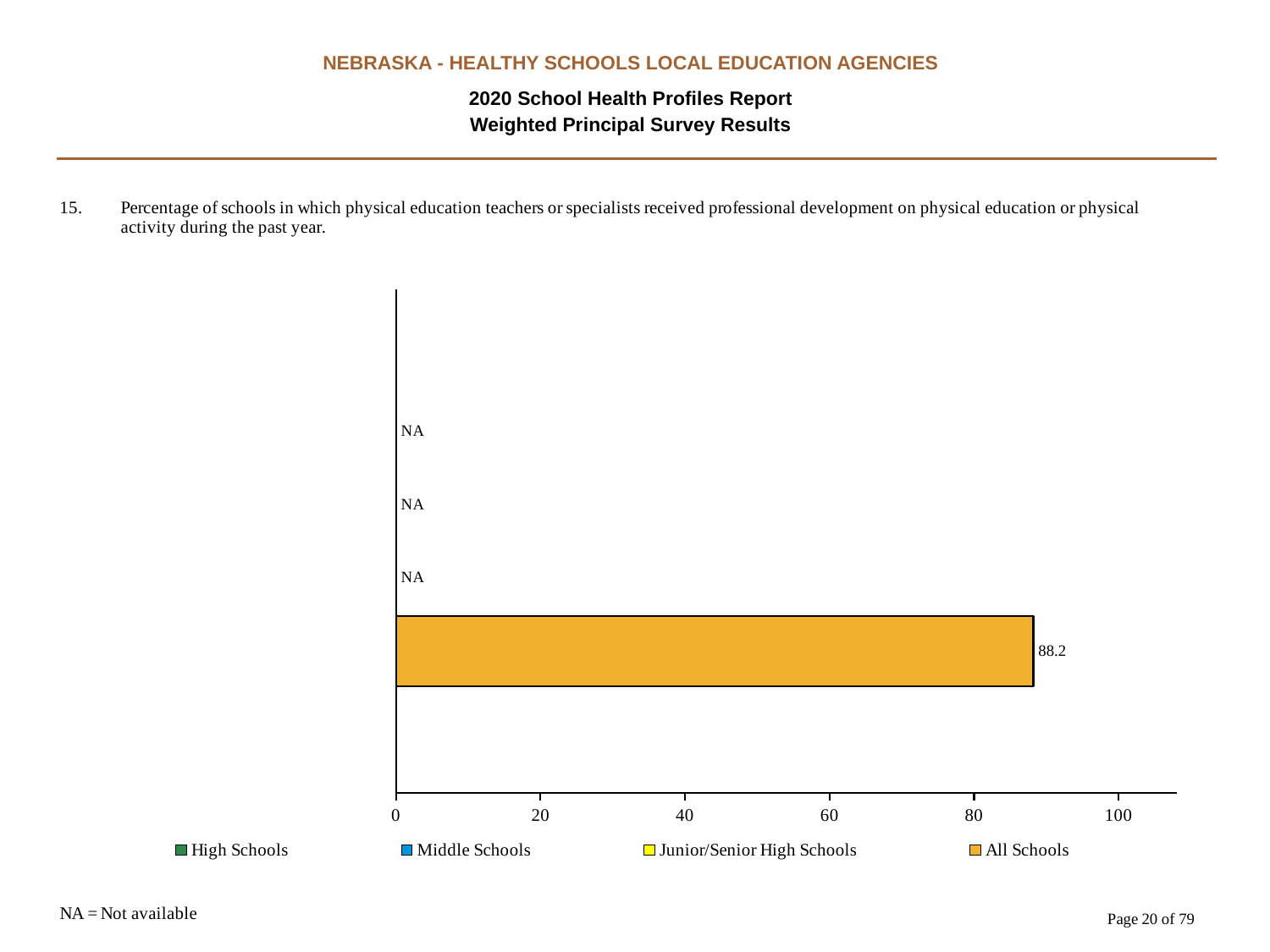
What is the highest value shown on the x axis? 100 Which series is shown in orange in the legend? All Schools Is the value for All Schools greater or less than 80? greater Which series is the only one with a plotted bar on the chart? All Schools How many bars on the chart are labelled NA? 3 Is the value for All Schools greater or less than 100? less How many series does the legend list? 4 What is the value shown for All Schools? 88.2 What kind of chart is shown on the slide? bar chart